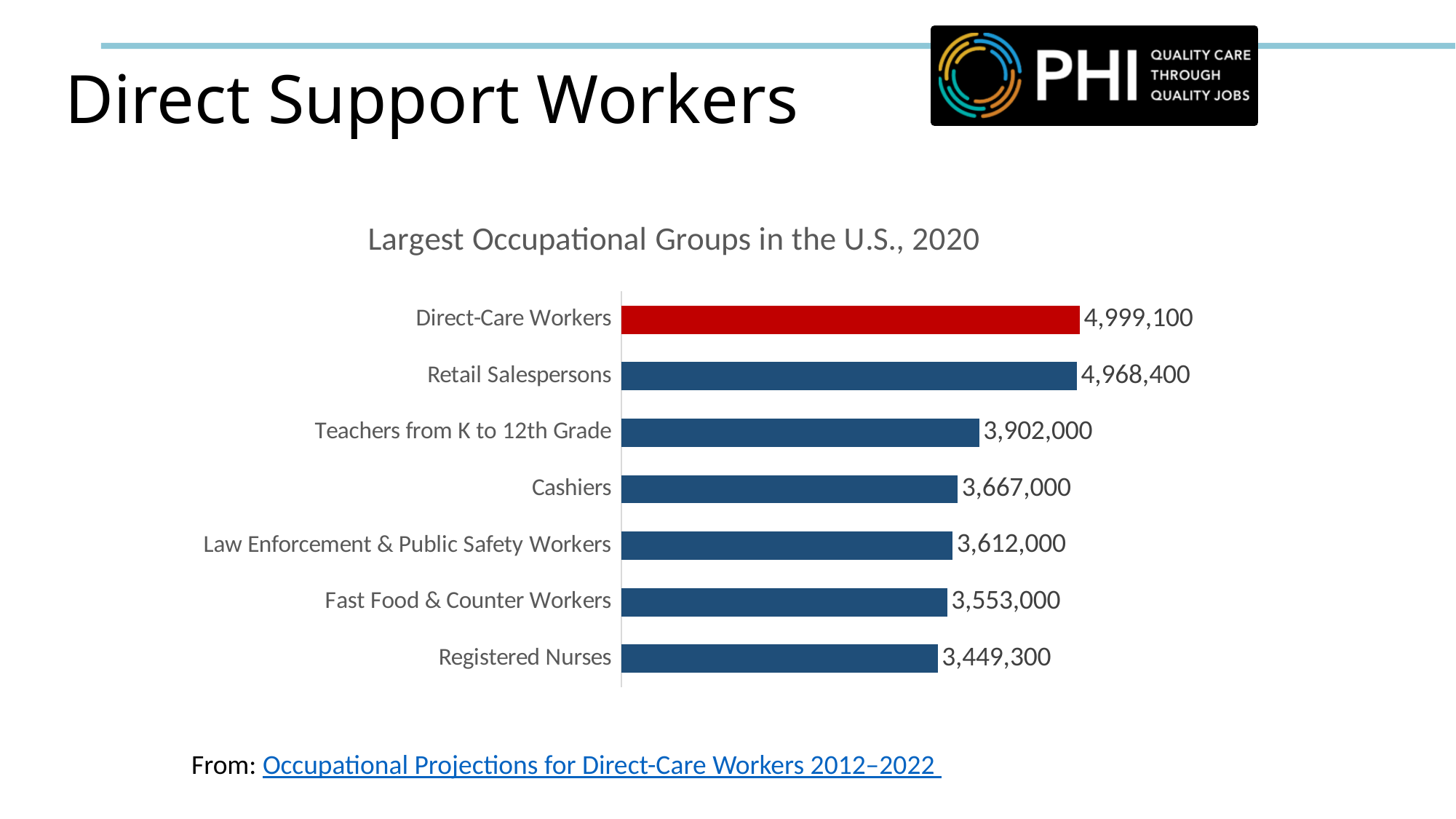
What is the title of the chart? Largest Occupational Groups in the U.S., 2020 What kind of chart is shown on the slide? Bar chart What is the value for Registered Nurses? 3,449,300 How many occupational groups are shown in the chart? 7 What is the value for Direct-Care Workers? 4,999,100 What is the value for Fast Food & Counter Workers? 3,553,000 Which occupational group has the lowest value? Registered Nurses What is the difference between the values for Direct-Care Workers and Retail Salespersons? 30,700 What is the difference between the values for Teachers from K to 12th Grade and Cashiers? 235,000 Which is larger, the value for Law Enforcement & Public Safety Workers or the value for Registered Nurses? Law Enforcement & Public Safety Workers Which occupational group has the highest value? Direct-Care Workers What is the value for Cashiers? 3,667,000